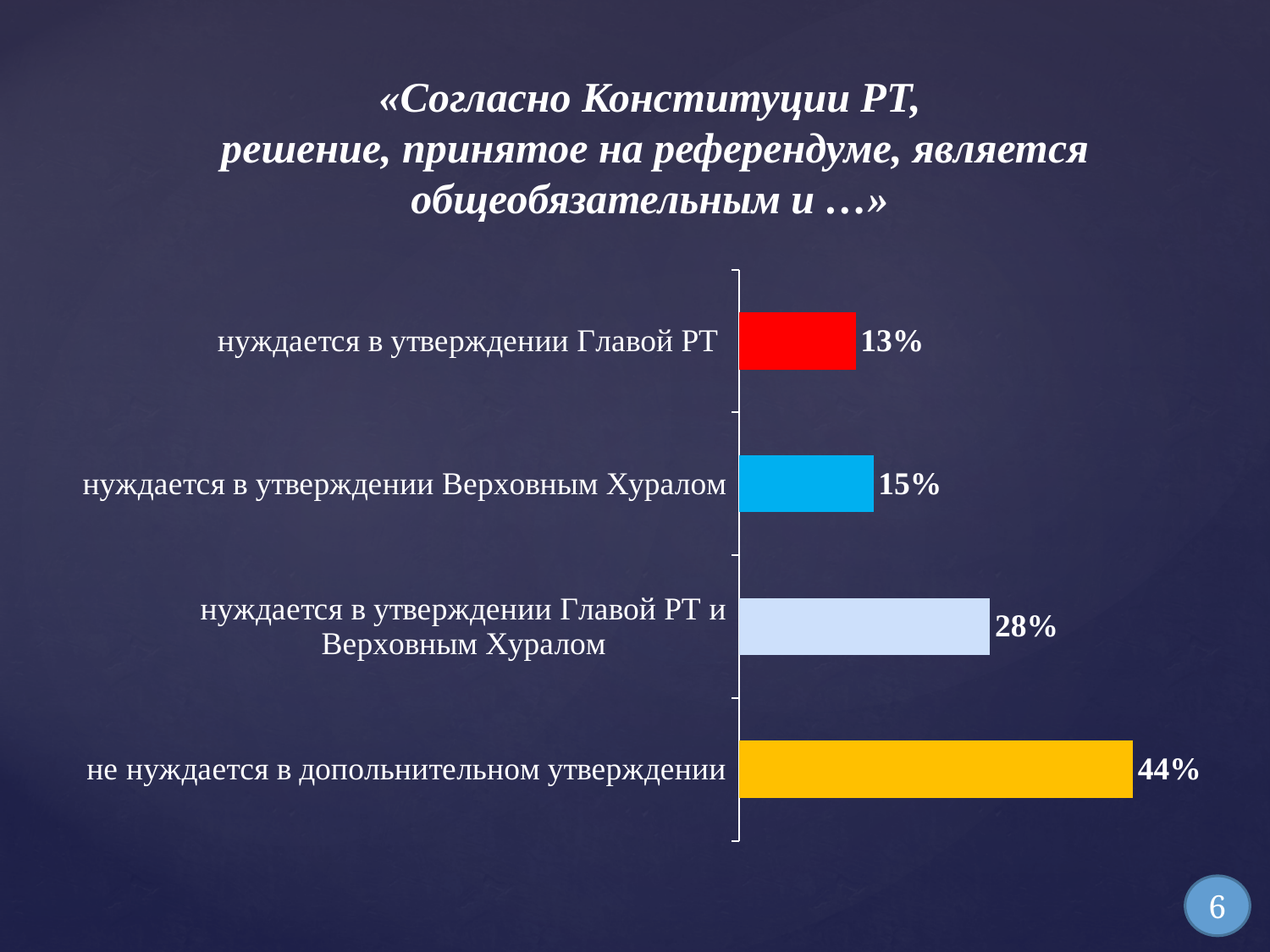
Which category has the highest value? не нуждается в дополнительном утверждении What kind of chart is shown on the slide? Bar chart What is the value for "не нуждается в дополнительном утверждении"? 44% What is the difference between the values for "не нуждается в дополнительном утверждении" and "нуждается в утверждении Главой РТ и Верховным Хуралом"? 16% How many categories are shown in the chart? 4 What is the difference between the values for "нуждается в утверждении Верховным Хуралом" and "нуждается в утверждении Главой РТ"? 2% Which is larger: the value for "нуждается в утверждении Главой РТ и Верховным Хуралом" or the value for "нуждается в утверждении Верховным Хуралом"? нуждается в утверждении Главой РТ и Верховным Хуралом What is the value for "нуждается в утверждении Главой РТ"? 13% What colour is the bar for "не нуждается в дополнительном утверждении"? Yellow Which category has the lowest value? нуждается в утверждении Главой РТ What is the value for "нуждается в утверждении Главой РТ и Верховным Хуралом"? 28% What is the value for "нуждается в утверждении Верховным Хуралом"? 15%